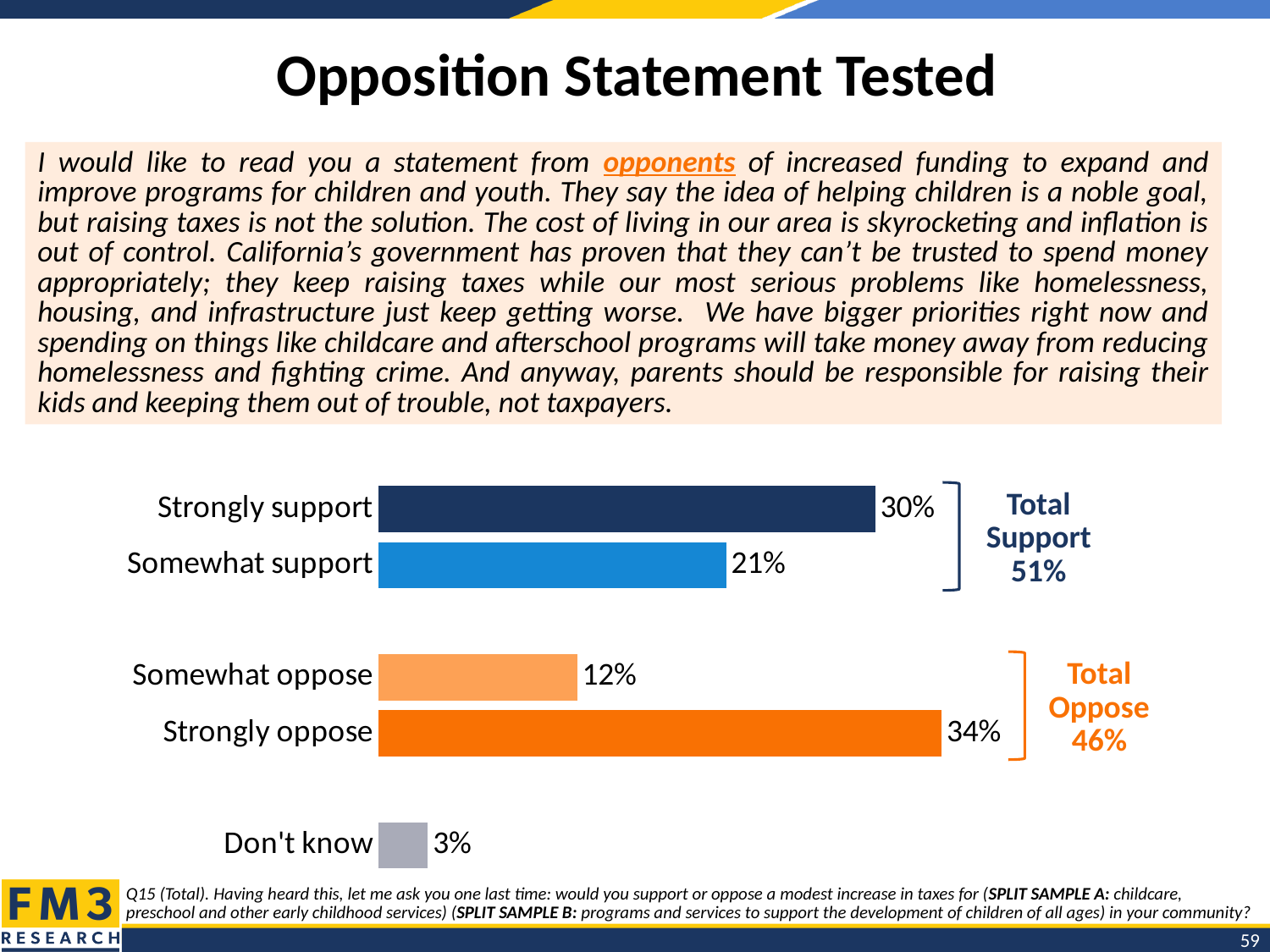
How many response categories are shown in the chart? 5 Which response category has the lowest percentage? Don't know What is the difference between the strongly oppose and strongly support percentages? 4% What percentage of respondents said they don't know? 3% What is the total oppose percentage shown on the chart? 46% What percentage of respondents said they strongly support? 30% What kind of chart is shown on the slide? Bar chart Which is larger, the somewhat support percentage or the somewhat oppose percentage? Somewhat support What is the total support percentage shown on the chart? 51% Which response category has the highest percentage? Strongly oppose What is the title of the slide? Opposition Statement Tested What percentage of respondents said they somewhat oppose? 12%